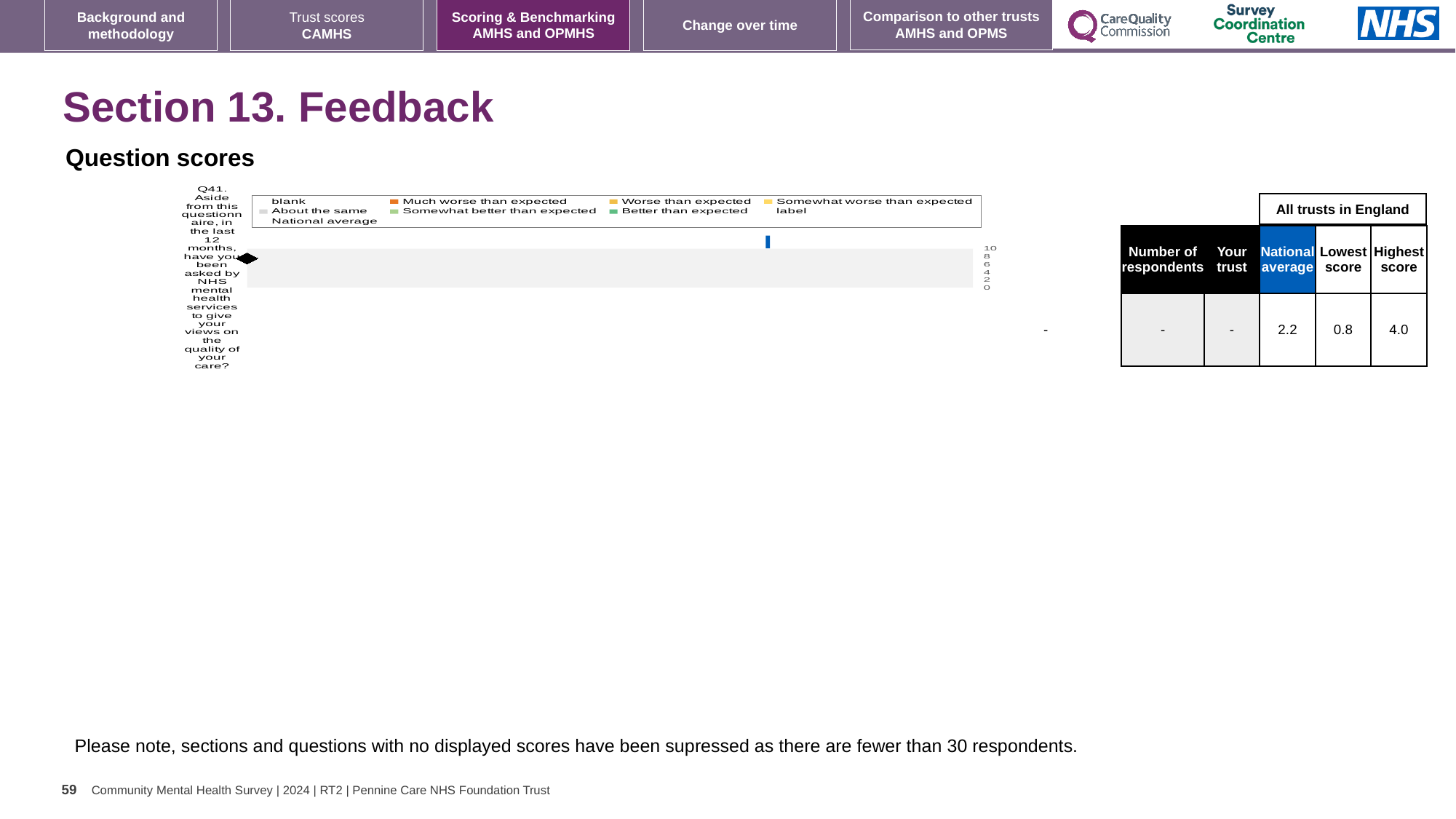
Which question is shown on the chart's vertical axis? Q41 In the table next to the chart, which is larger for Q41: the national average or the lowest score? national average In the table next to the chart, what is the difference between the highest score and the lowest score for Q41? 3.2 In the table next to the chart, what is the national average score for Q41? 2.2 In the table next to the chart, what is the highest score among all trusts in England for Q41? 4.0 In the table next to the chart, what is the lowest score among all trusts in England for Q41? 0.8 What kind of chart is shown under 'Question scores'? bar chart In the table next to the chart, what value is shown for 'Your trust' for Q41? - How many questions (categories) are listed on the chart's vertical axis? 1